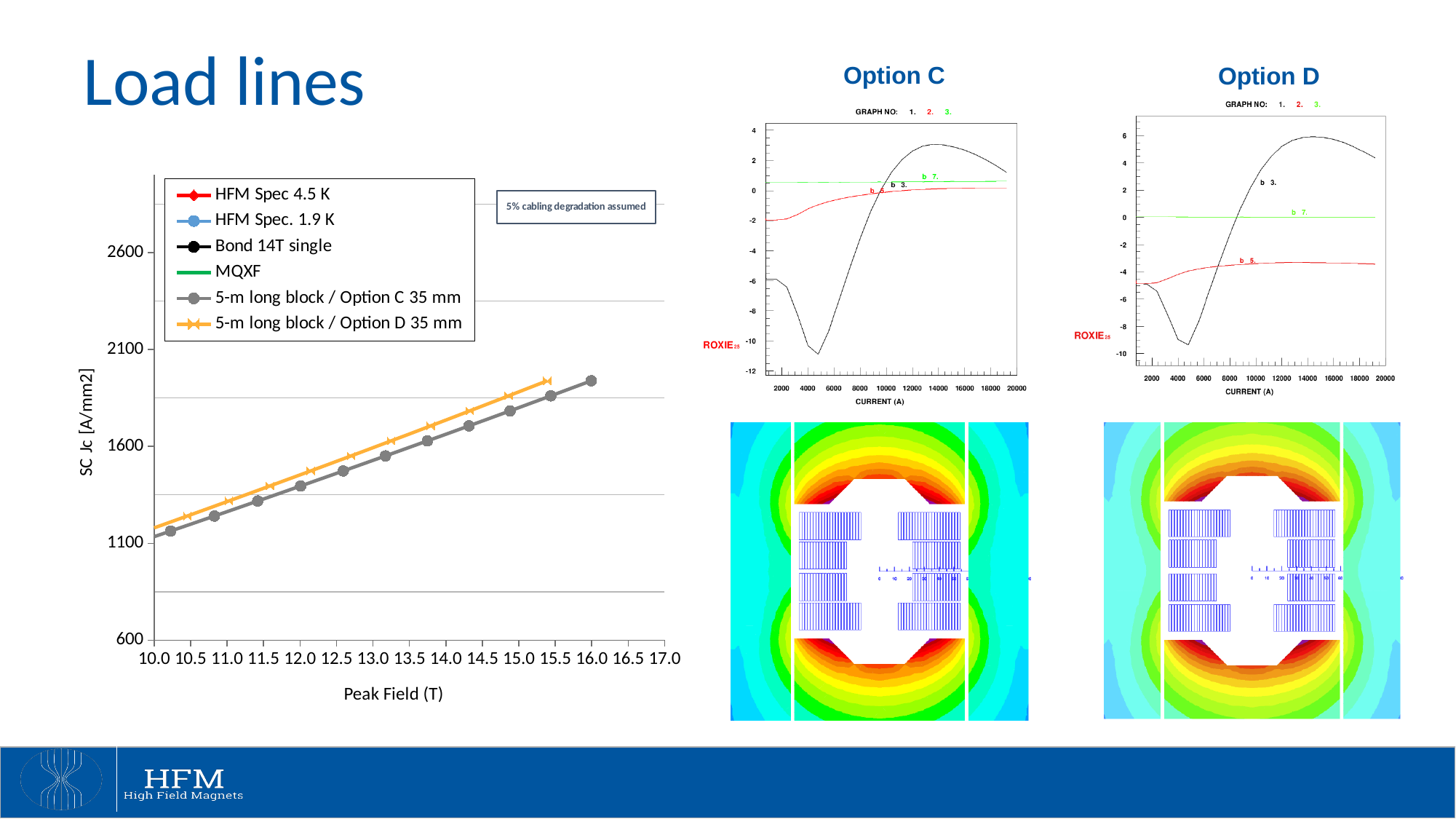
On the Load lines chart, what is the label of the x axis? Peak Field (T) On the Option D graph (top right), is the peak value of the black 'b 3.' curve greater or less than 4? greater On the Load lines chart, at a Peak Field of 14.0 T, which series has the higher SC Jc: '5-m long block / Option C 35 mm' or '5-m long block / Option D 35 mm'? 5-m long block / Option D 35 mm On the Option C graph (top right), what is the title of the x axis? CURRENT (A) On the Load lines chart, do the values of the '5-m long block / Option C 35 mm' series rise or fall as Peak Field increases? rise On the Load lines chart, is the SC Jc value of the '5-m long block / Option C 35 mm' series at 16.0 T greater or less than 1600? greater On the Load lines chart, is the SC Jc value of the '5-m long block / Option D 35 mm' series at 15.5 T greater or less than 2100? less On the Load lines chart, how many series does the legend list? 6 On the Load lines chart, what kind of chart is it? line chart On the Load lines chart, do the values of the '5-m long block / Option D 35 mm' series rise or fall as Peak Field increases? rise On the Load lines chart, what is the label of the y axis? SC Jc [A/mm2]